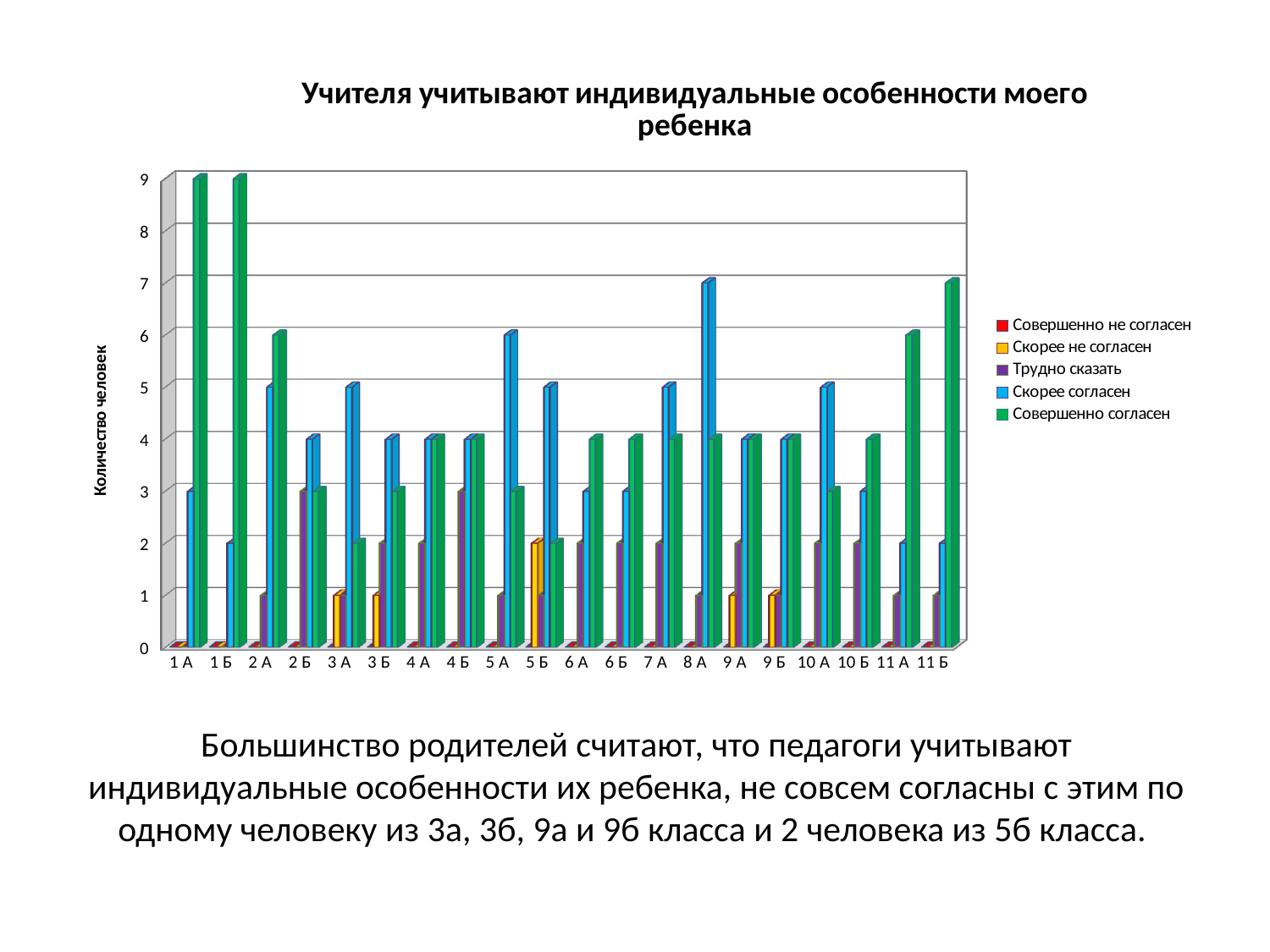
What kind of chart is shown on the slide? Bar chart Which legend entry is shown in green? Совершенно согласен Which is larger in class 2 А: 'Скорее согласен' or 'Совершенно согласен'? Совершенно согласен How many classes (categories) are shown along the x axis? 20 What is the value for 'Скорее согласен' in class 8 А? 7 Is the value for 'Совершенно согласен' in class 11 Б greater or less than 5? greater How many series does the legend list? 5 What is the difference between 'Совершенно согласен' in class 1 Б and 'Скорее согласен' in class 1 Б? 7 What is the title of the chart? Учителя учитывают индивидуальные особенности моего ребенка Which class has the highest value for 'Скорее согласен'? 8 А What is the value for 'Скорее не согласен' in class 5 Б? 2 What is the value for 'Совершенно согласен' in class 1 А? 9